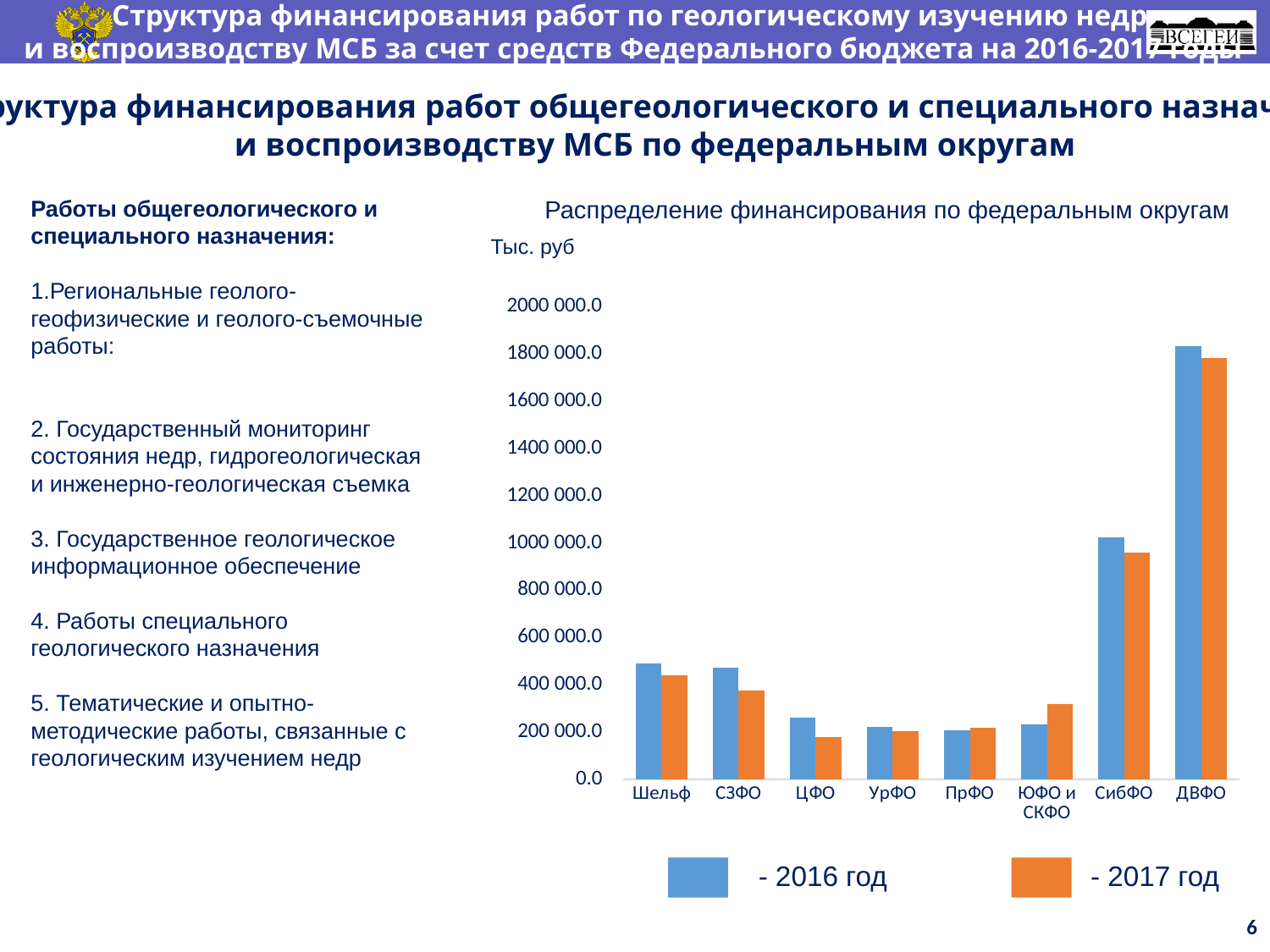
Is the value for ЦФО in 2017 год greater or less than 200 000.0? less Is the value for ДВФО in 2016 год greater or less than 1600 000.0? greater Is the value for СибФО in 2017 год greater or less than 1000 000.0? less How many federal district categories are shown on the x axis of the chart? 8 What kind of chart is shown on the slide? bar chart What is the title of the chart? Распределение финансирования по федеральным округам Which category has the highest value for 2016 год? ДВФО Which category has the lowest value for 2017 год? ЦФО Which category has the highest value for 2017 год? ДВФО For ЮФО и СКФО, which series has the larger value, 2016 год or 2017 год? 2017 год How many series does the chart legend list? 2